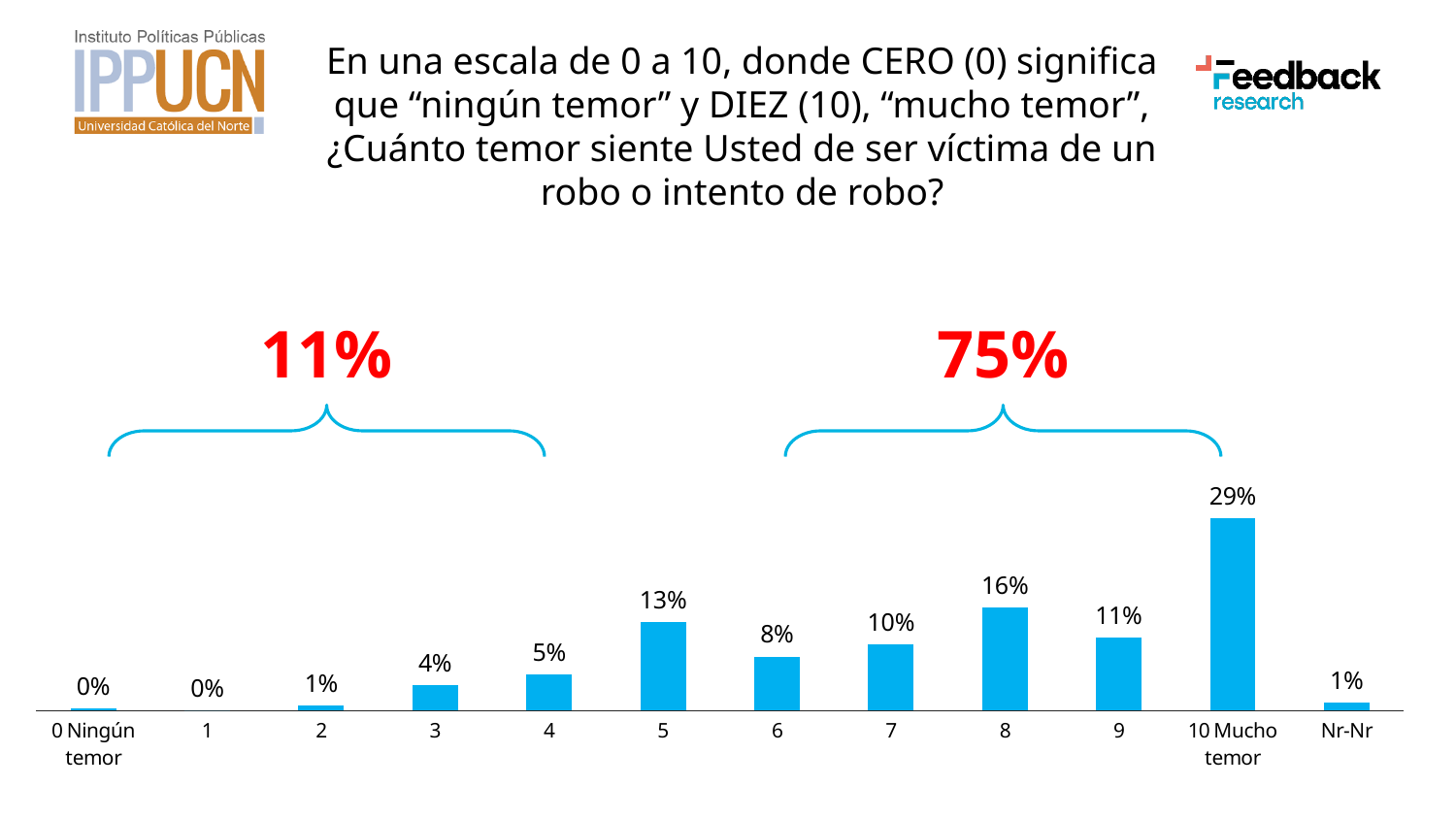
What is the value shown for category 5? 13% Which is larger, the value for category 7 or the value for category 9? category 9 What kind of chart is shown on the slide? bar chart What percentage of respondents answered 10 Mucho temor? 29% What percentage is shown in red above the bracket covering categories 6 to 10? 75% How many categories are shown on the x axis? 12 What is the difference between the values for category 8 and category 6? 8% What is the value for the Nr-Nr category? 1% Which category has the highest value? 10 Mucho temor What percentage is shown for category 8? 16% Which is larger, the value for category 3 or the value for category 4? category 4 What is the difference between the values for 10 Mucho temor and category 9? 18%